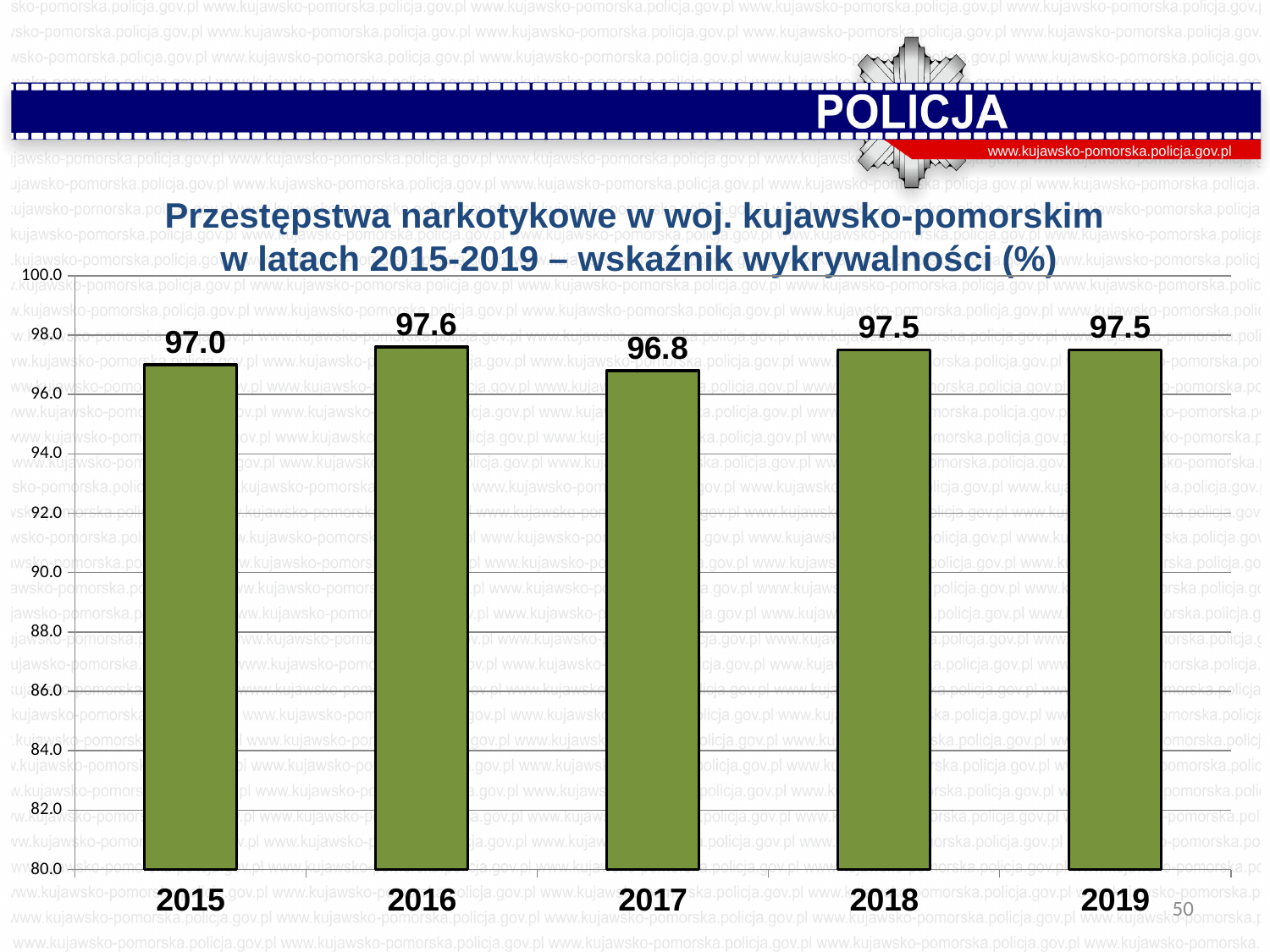
What is the detection rate value shown for 2016? 97.6 Which is larger, the value for 2015 or the value for 2018? 2018 What is the difference between the values for 2016 and 2015? 0.6 What is the value shown for 2017? 96.8 Which year has the highest value in the chart? 2016 What kind of chart is shown on the slide? bar chart Which year has the lowest value in the chart? 2017 What is the value shown for 2015? 97.0 How many years are shown on the x axis of the chart? 5 What is the difference between the values for 2016 and 2017? 0.8 Does the value rise or fall from 2016 to 2017? fall Is the value for 2017 greater or less than 96.0? greater